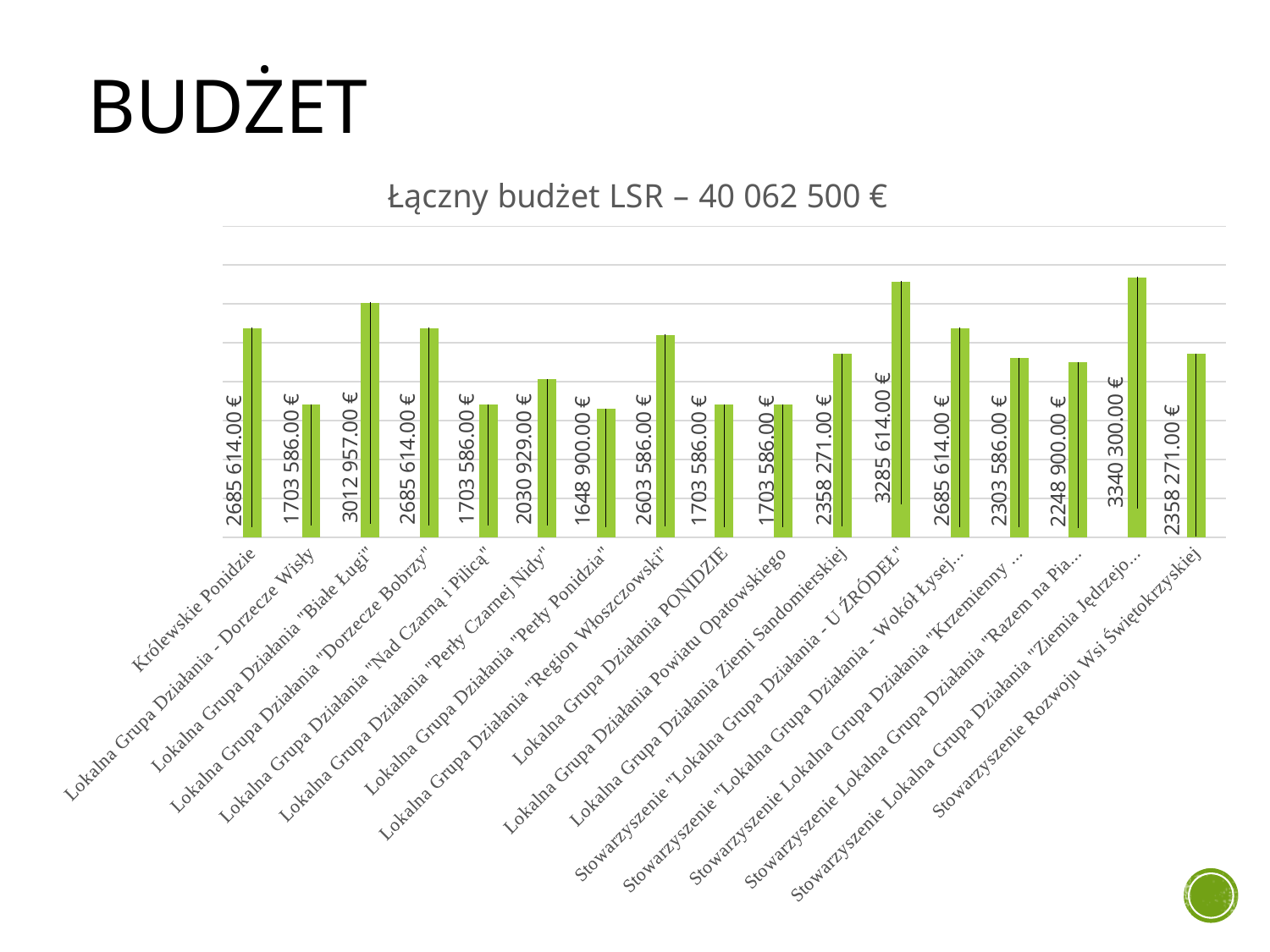
Which has a larger budget: Lokalna Grupa Działania "Region Włoszczowski" or Lokalna Grupa Działania "Perły Czarnej Nidy"? Lokalna Grupa Działania "Region Włoszczowski" What is the budget value shown for Królewskie Ponidzie? 2685 614.00 € What is the budget value shown for Lokalna Grupa Działania "Białe Ługi"? 3012 957.00 € What is the budget value shown for Lokalna Grupa Działania "Perły Czarnej Nidy"? 2030 929.00 € What type of chart is shown on the slide? Bar chart What is the budget value shown for Stowarzyszenie "Lokalna Grupa Działania - U ŹRÓDEŁ"? 3285 614.00 € What is the budget value shown for Stowarzyszenie Rozwoju Wsi Świętokrzyskiej? 2358 271.00 € How many categories (bars) are shown in the chart? 17 Which category has the lowest budget value in the chart? Lokalna Grupa Działania "Perły Ponidzia" Which category has the highest budget value in the chart? Stowarzyszenie Lokalna Grupa Działania "Ziemia Jędrzejo..." What is the difference between the budget of Stowarzyszenie "Lokalna Grupa Działania - U ŹRÓDEŁ" and Lokalna Grupa Działania Ziemi Sandomierskiej? 927 343.00 € What total budget is stated in the chart title? 40 062 500 €